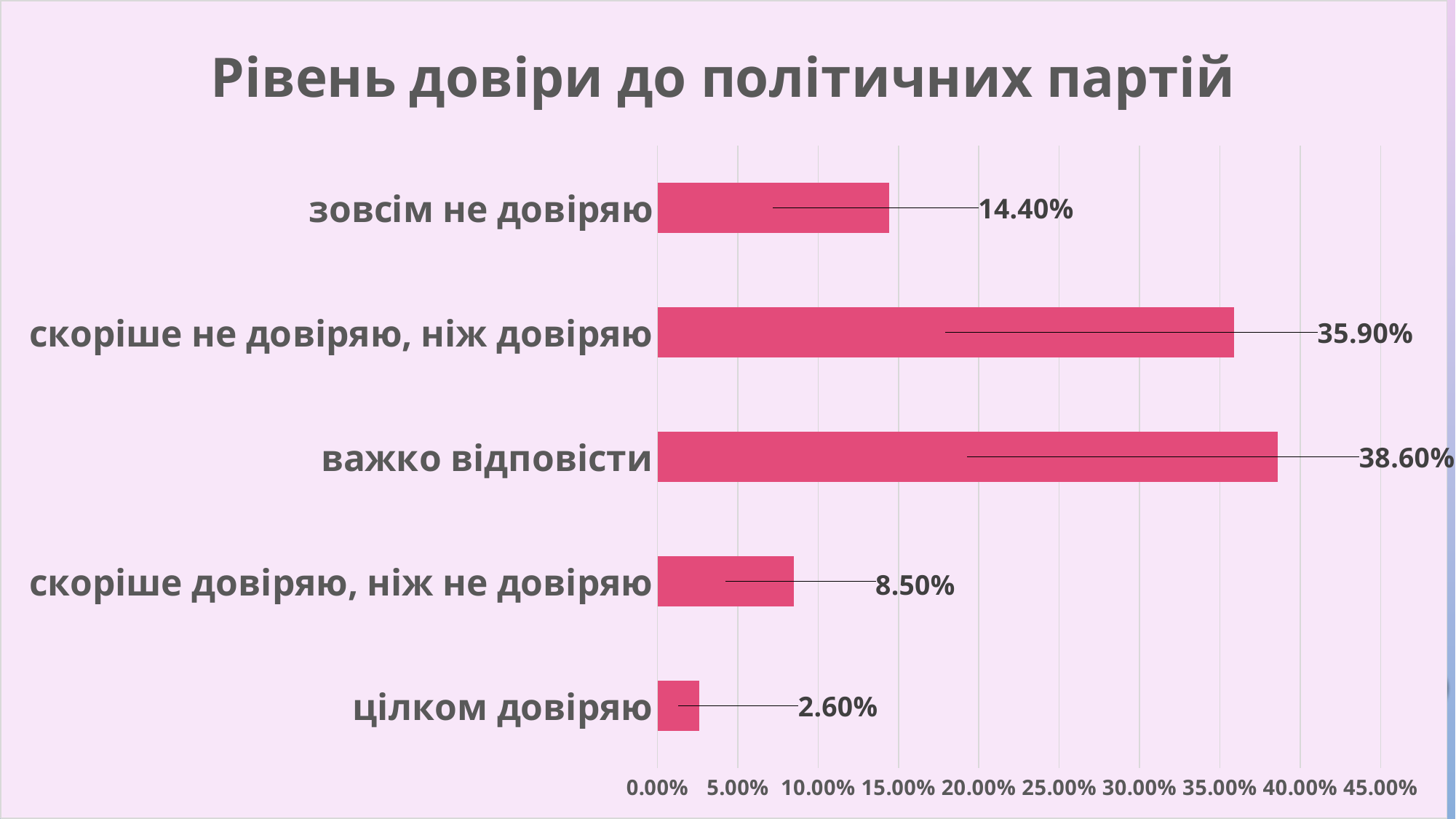
What is the value for "скоріше не довіряю, ніж довіряю"? 35.90% Which category has the highest value? важко відповісти What kind of chart is shown on the slide? bar chart Is the value for "скоріше не довіряю, ніж довіряю" greater or less than 30.00%? greater What is the title of the chart? Рівень довіри до політичних партій What is the difference between the values for "важко відповісти" and "скоріше не довіряю, ніж довіряю"? 2.70% How many categories are shown in the chart? 5 What is the value for "цілком довіряю"? 2.60% Which is larger: the value for "зовсім не довіряю" or the value for "скоріше довіряю, ніж не довіряю"? зовсім не довіряю What is the difference between the values for "зовсім не довіряю" and "скоріше довіряю, ніж не довіряю"? 5.90% What is the value for "зовсім не довіряю"? 14.40% Which category has the lowest value? цілком довіряю